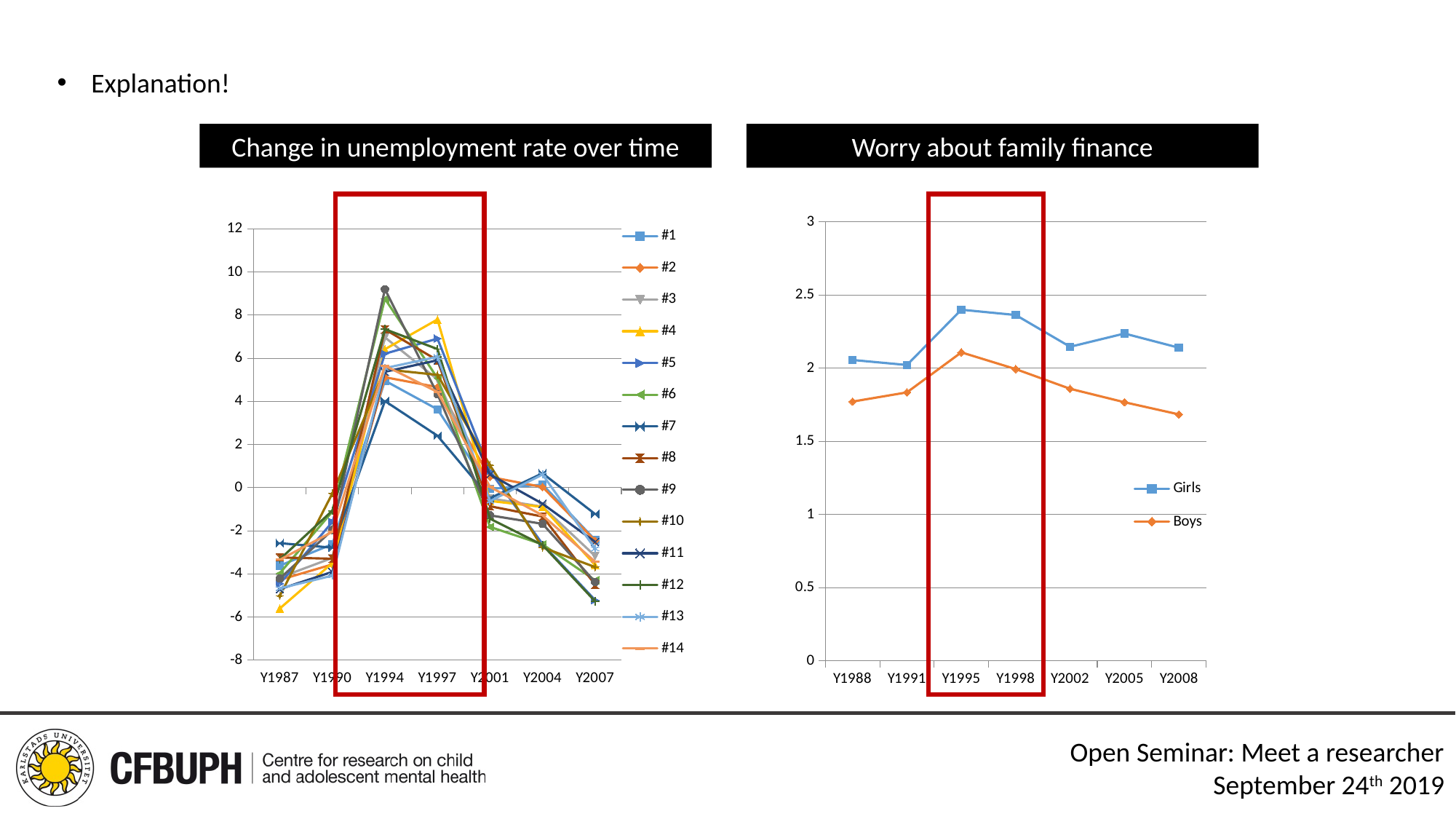
In the 'Worry about family finance' chart, is the Boys value at Y2008 greater or less than 2? less In the 'Worry about family finance' chart, in which year is the Boys value highest? Y1995 In the 'Worry about family finance' chart, which is larger at Y1995, Girls or Boys? Girls In the 'Change in unemployment rate over time' chart, is the value for series #4 at Y1997 greater or less than 6? greater In the 'Change in unemployment rate over time' chart, do the values rise or fall from Y1990 to Y1994? rise In the 'Worry about family finance' chart, in which year is the Boys value lowest? Y2008 How many years are shown on the x axis of the 'Worry about family finance' chart? 7 How many series does the legend of the 'Change in unemployment rate over time' chart list? 14 In the 'Change in unemployment rate over time' chart, is the value for series #4 at Y1987 greater or less than -4? less How many series does the legend of the 'Worry about family finance' chart list? 2 How many years are shown on the x axis of the 'Change in unemployment rate over time' chart? 7 What kind of chart is the 'Change in unemployment rate over time' chart? line chart